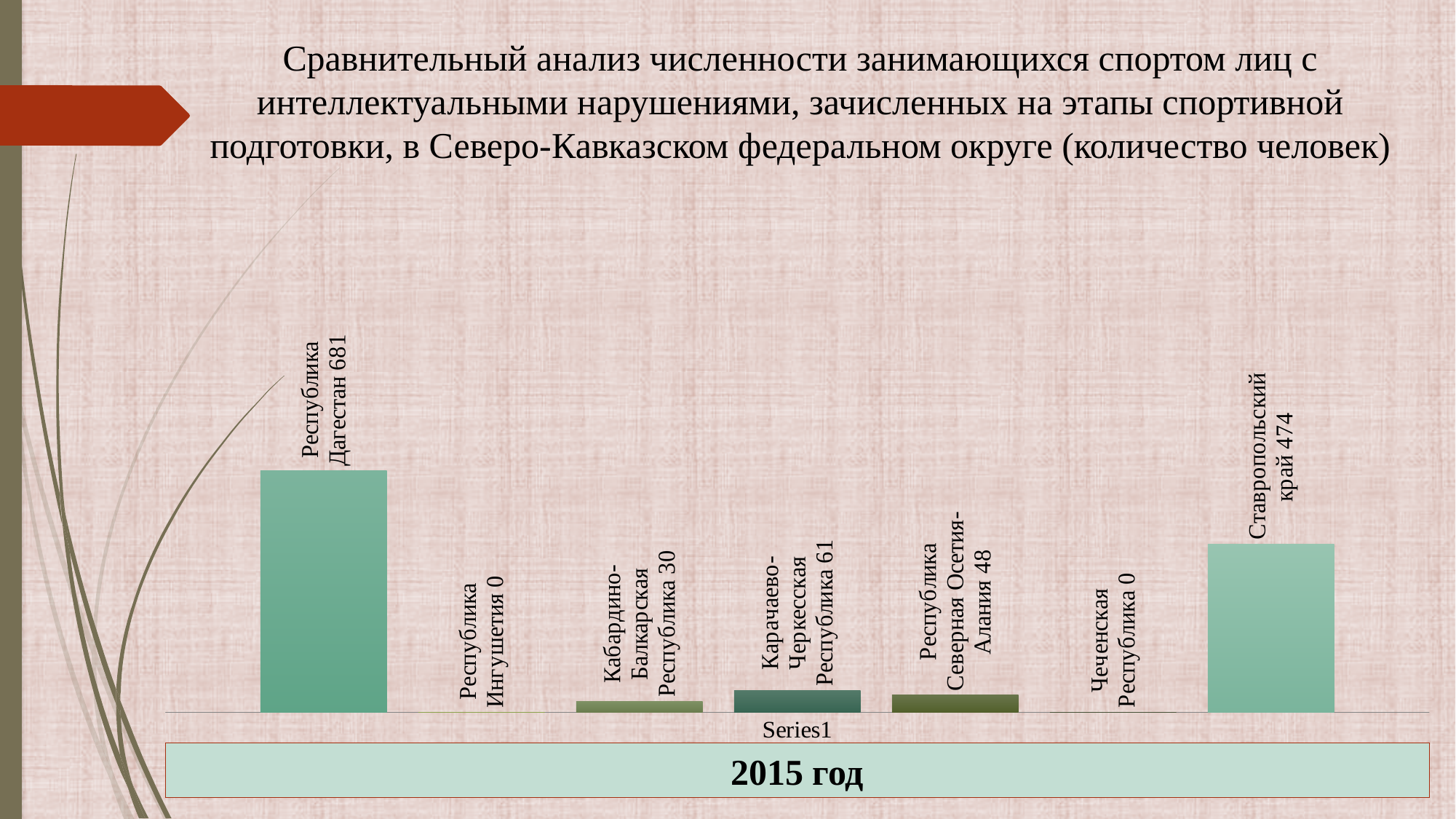
What is the value for Кабардино-Балкарская Республика? 30 Which region has the highest value? Республика Дагестан How many regions are shown in the chart? 7 What is the difference between the values for Республика Дагестан and Ставропольский край? 207 What is the value for Республика Дагестан? 681 Which year does the chart refer to, according to the label below it? 2015 год Which regions have a value of 0? Республика Ингушетия and Чеченская Республика What is the value for Республика Северная Осетия-Алания? 48 Which is larger, the value for Карачаево-Черкесская Республика or Республика Северная Осетия-Алания? Карачаево-Черкесская Республика What kind of chart is shown on the slide? Bar chart What is the value for Карачаево-Черкесская Республика? 61 What is the value for Ставропольский край? 474